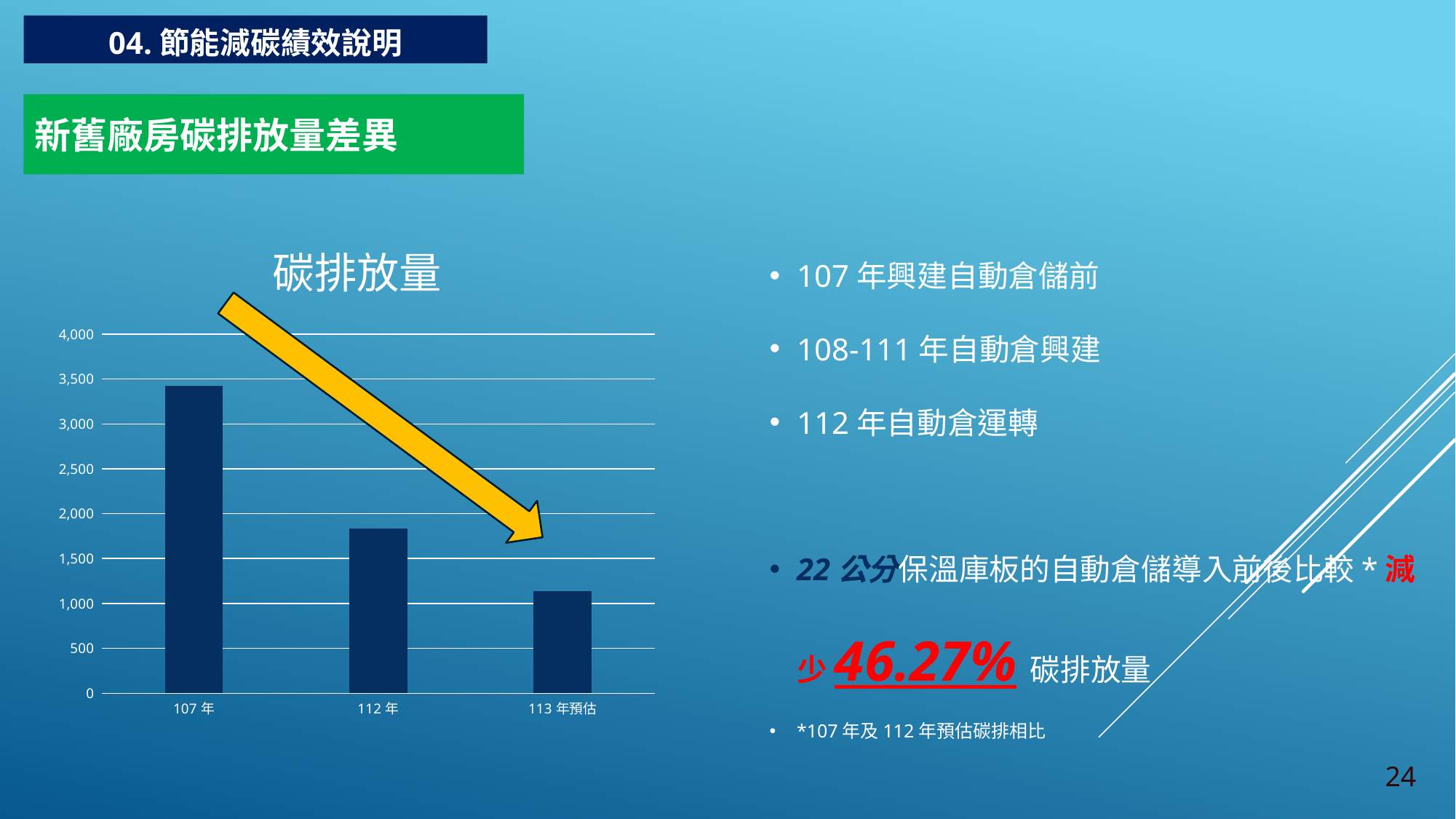
What is the highest value shown on the chart's vertical axis? 4,000 Which category has the lowest value in the chart? 113 年預估 Which is larger, the value for 112 年 or the value for 113 年預估? 112 年 How many categories are plotted on the x axis of the chart? 3 Is the value for 107 年 greater or less than 3,000? greater Is the value for 112 年 greater or less than 2,000? less What kind of chart is shown on the slide? bar chart Do the values rise or fall from left to right along the x axis? fall Is the value for 113 年預估 greater or less than 1,000? greater What is the title of the chart? 碳排放量 Which category has the highest value in the chart? 107 年